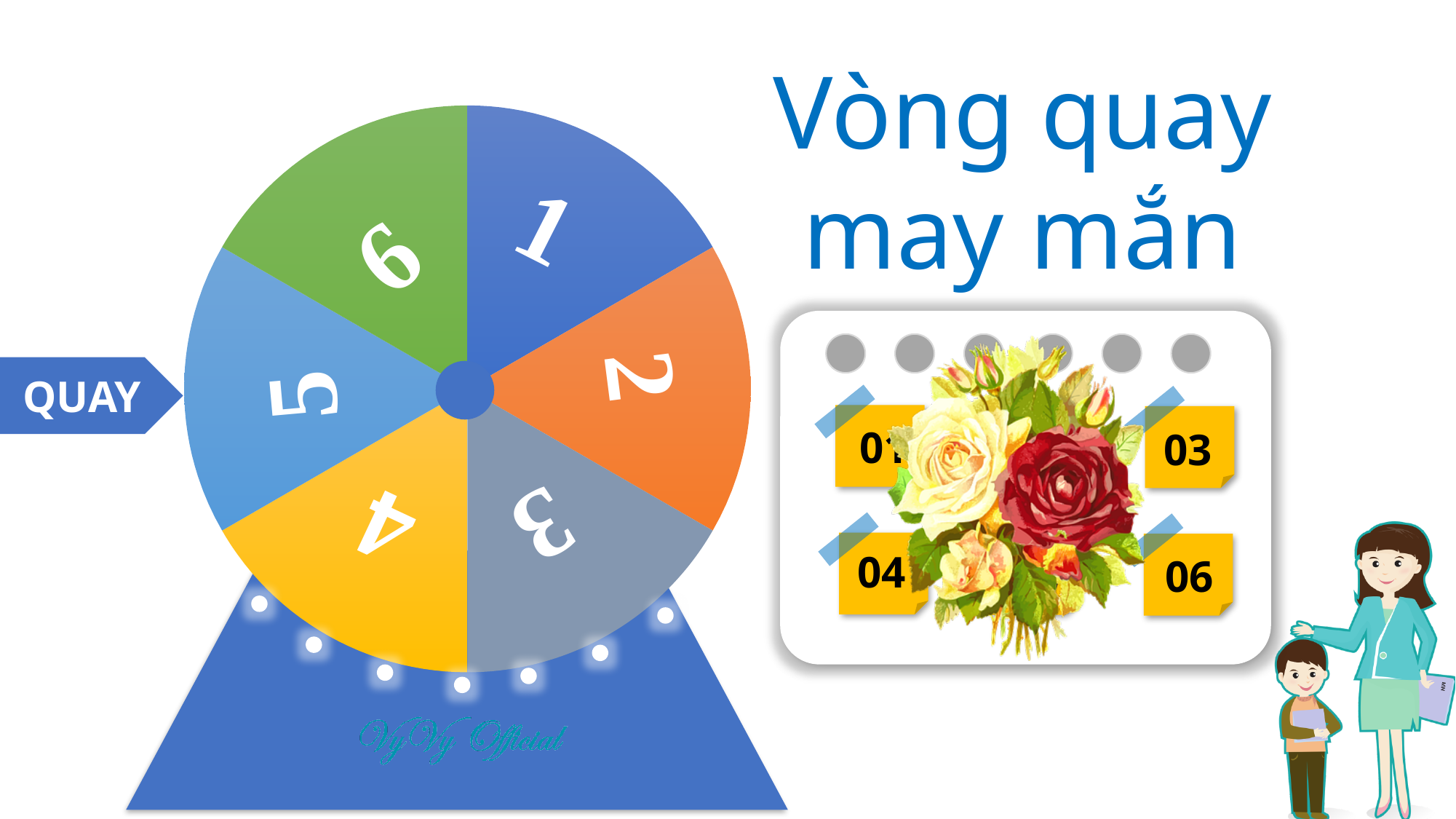
Which number is on the grey segment of the wheel? 3 What word is written on the blue arrow button to the left of the wheel? QUAY What colour is the segment labelled 2 on the wheel? orange What is the highest number printed on the wheel? 6 What kind of chart is the wheel on the left drawn as? pie chart Which number is on the yellow segment of the wheel? 4 Which number is on the green segment of the wheel? 6 How many numbered segments does the wheel on the left have? 6 What is the title shown at the top right of the slide? Vòng quay may mắn What is the lowest number printed on the wheel? 1